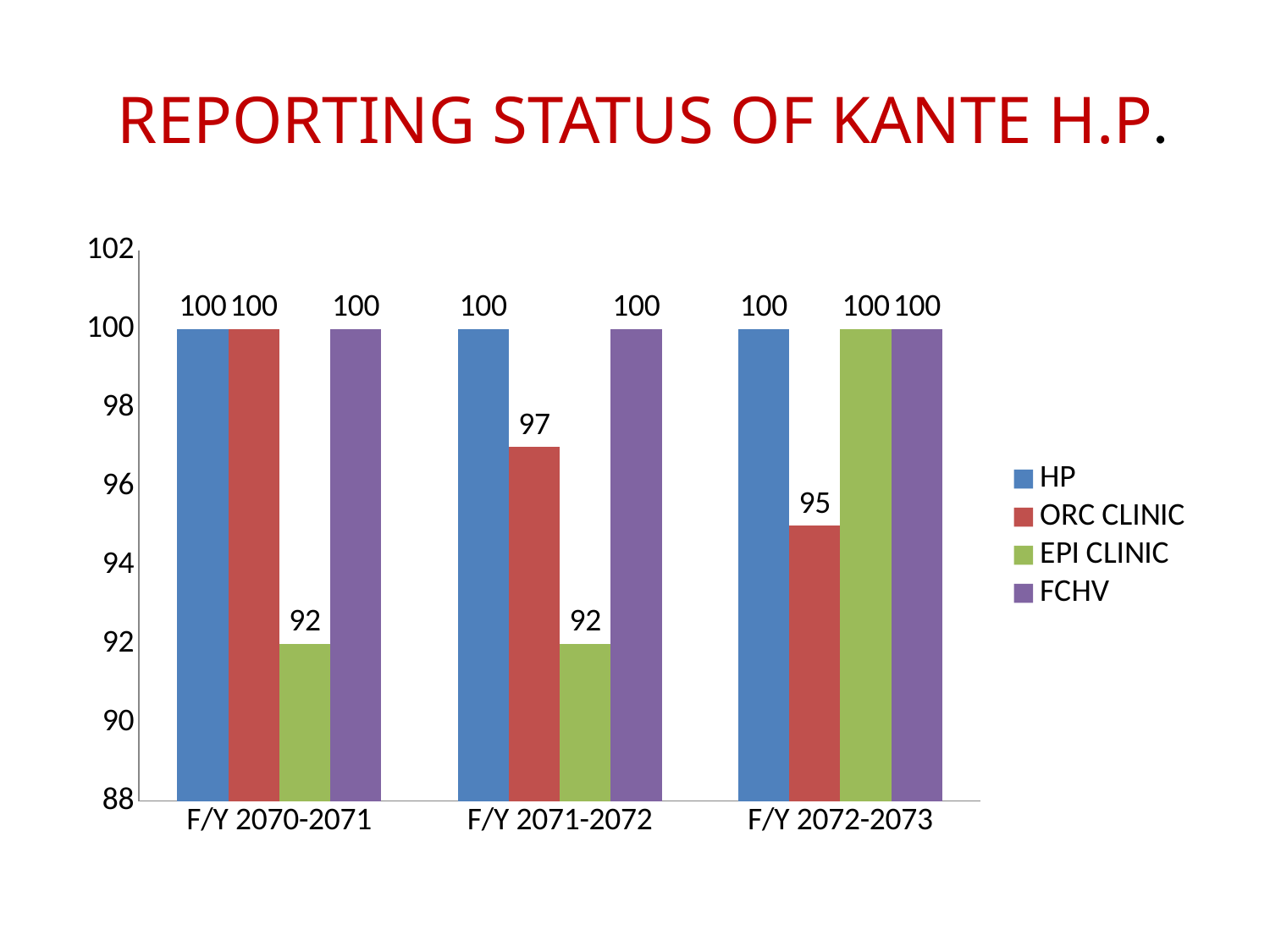
How many series does the legend list? 4 How many fiscal year categories are shown on the x axis? 3 Does the ORC CLINIC value rise or fall from F/Y 2070-2071 to F/Y 2072-2073? Fall What is the value for EPI CLINIC in F/Y 2070-2071? 92 Which is larger, the ORC CLINIC value in F/Y 2071-2072 or the ORC CLINIC value in F/Y 2072-2073? F/Y 2071-2072 What kind of chart is shown on the slide? Bar chart What is the value for FCHV in F/Y 2071-2072? 100 What is the value for ORC CLINIC in F/Y 2071-2072? 97 Which series has the lowest value in F/Y 2071-2072? EPI CLINIC Which series has the lowest value in F/Y 2072-2073? ORC CLINIC What is the value for ORC CLINIC in F/Y 2072-2073? 95 What is the difference between the ORC CLINIC value and the EPI CLINIC value in F/Y 2071-2072? 5